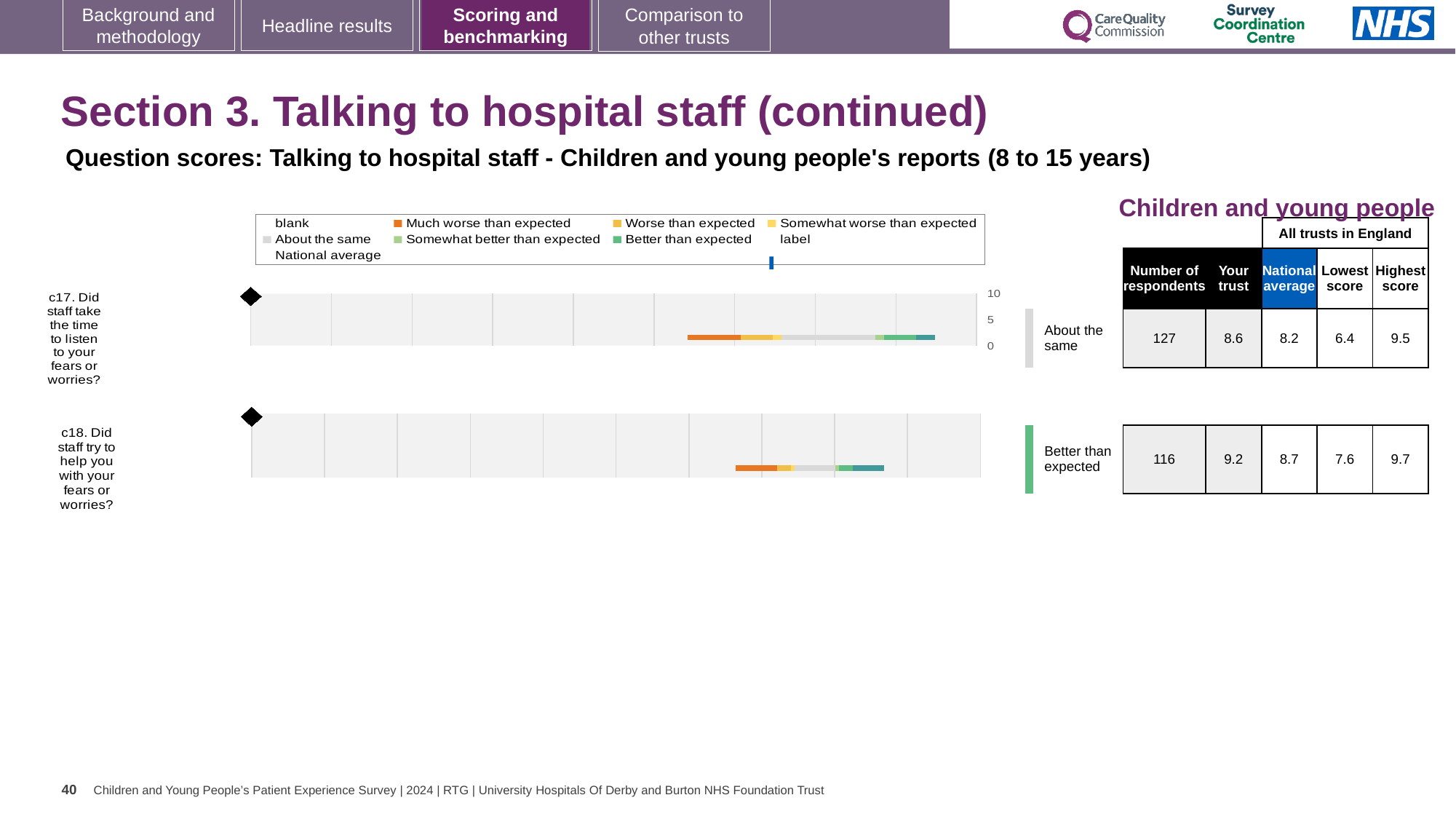
How many questions (categories) are plotted on the slide? 2 What kind of chart is used to show the question scores for c17 and c18? bar chart Which question has the higher 'Your trust' score, c17 or c18? c18 What is the difference between the highest and lowest scores across all trusts for c17? 3.1 How many respondents answered question c17? 127 What is the 'Your trust' score for c17 (Did staff take the time to listen to your fears or worries?)? 8.6 What is the difference between the trust's score and the national average for c18? 0.5 Which question has the larger number of respondents? c17 What is the national average score for c18 (Did staff try to help you with your fears or worries?)? 8.7 What benchmark category is shown for c18? Better than expected What is the lowest score among all trusts in England for c18? 7.6